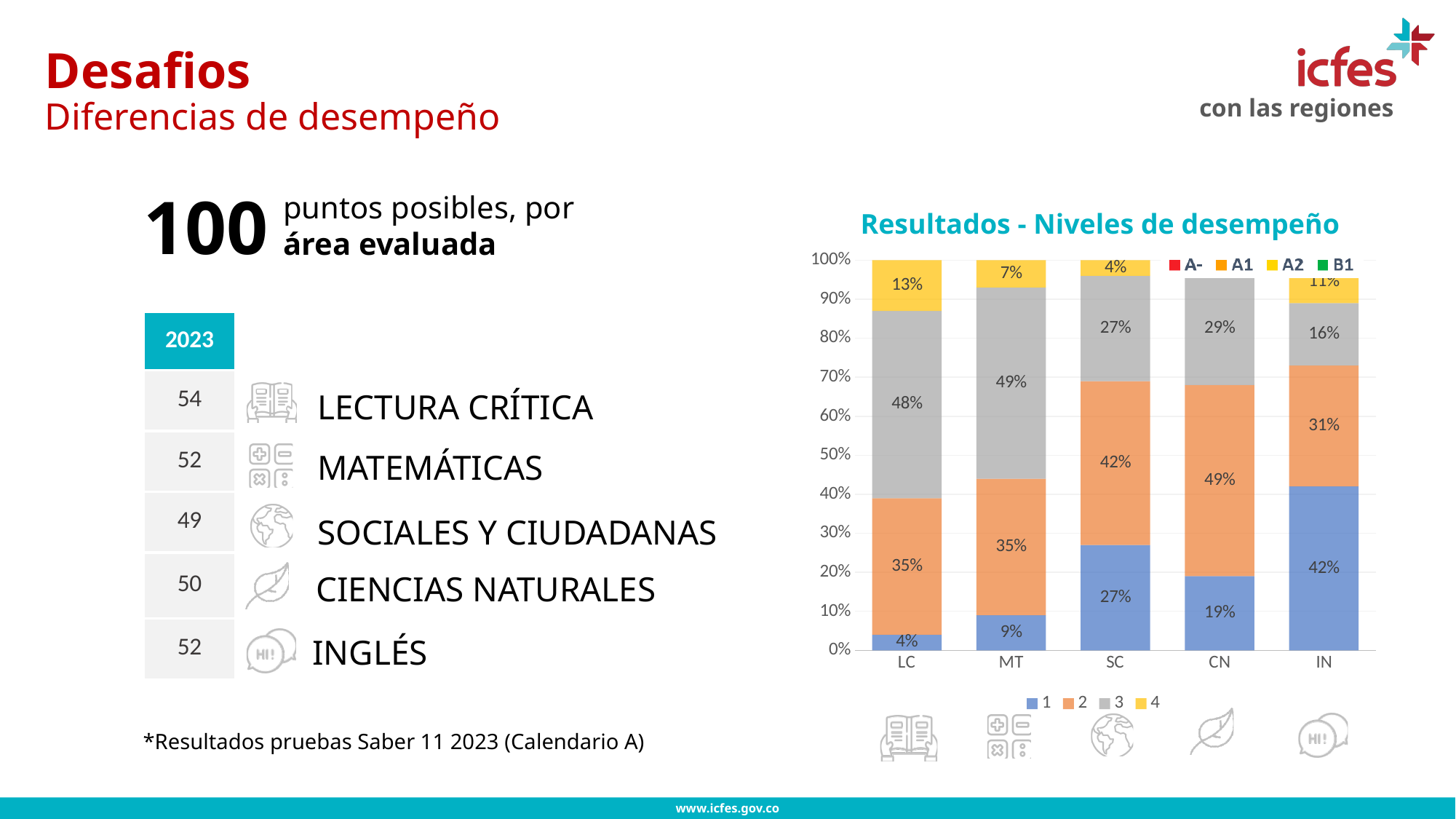
In the "Resultados - Niveles de desempeño" chart, what is the value of series 3 for MT? 49% How many categories are shown on the x axis of the "Resultados - Niveles de desempeño" chart? 5 In the "Resultados - Niveles de desempeño" chart, which category has the lowest value for series 1? LC In the "Resultados - Niveles de desempeño" chart, what is the value of series 2 for CN? 49% In the "Resultados - Niveles de desempeño" chart, what is the value of series 4 for LC? 13% In the "Resultados - Niveles de desempeño" chart, which is larger: series 3 for LC or series 3 for SC? series 3 for LC In the "Resultados - Niveles de desempeño" chart, what is the difference between the series 2 values for SC and LC? 7% In the "Resultados - Niveles de desempeño" chart, what colour represents series 2? orange How many series does the bottom legend of the "Resultados - Niveles de desempeño" chart list? 4 In the "Resultados - Niveles de desempeño" chart, which category has the highest value for series 1? IN In the "Resultados - Niveles de desempeño" chart, what is the value of series 1 for IN? 42% What type of chart is shown under the title "Resultados - Niveles de desempeño"? stacked bar chart